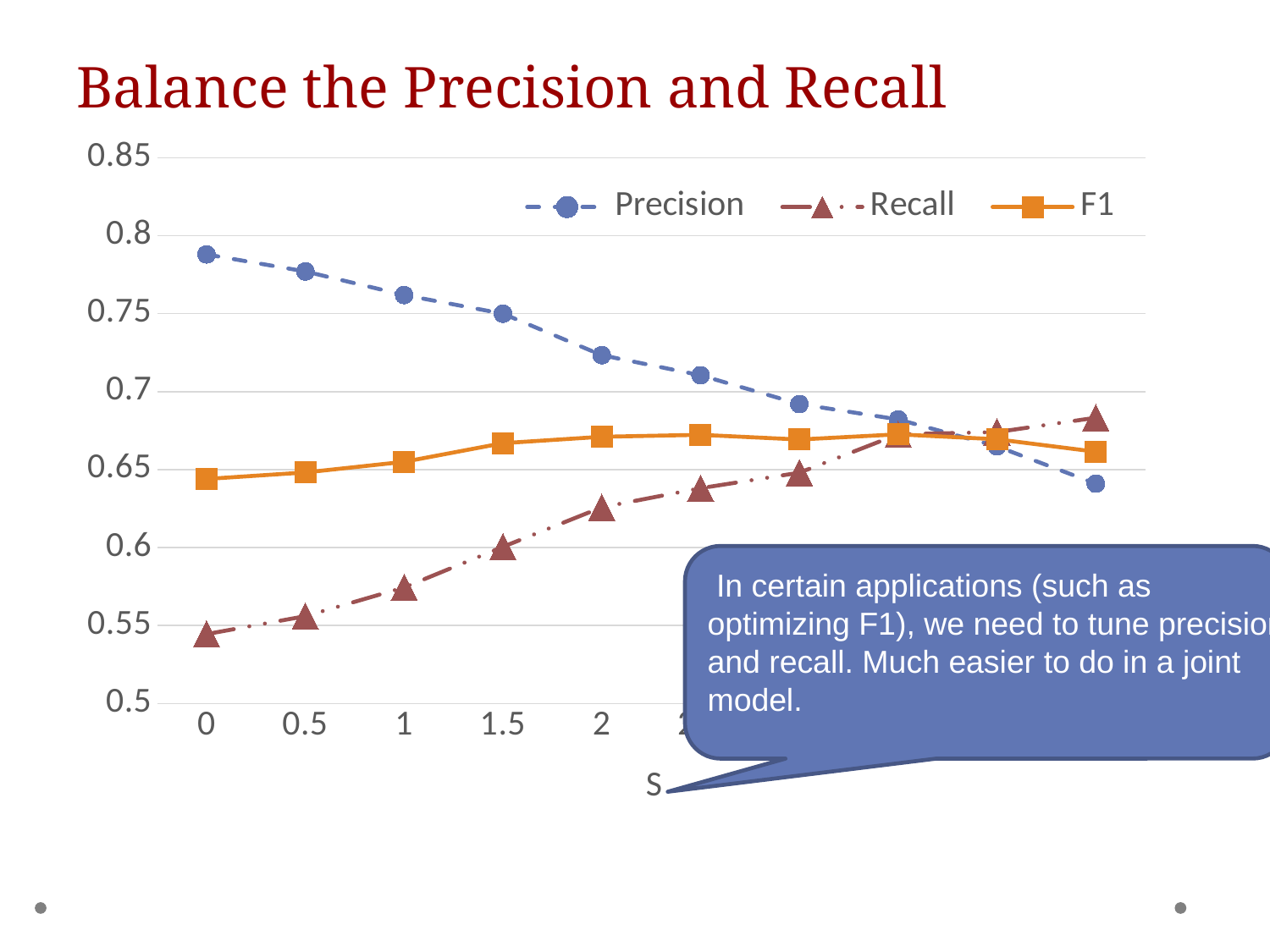
Is the Recall value at S = 0 greater or less than 0.6? less Does the Recall series rise or fall as S increases along the x axis? rise Is the Recall value at S = 2 greater or less than 0.6? greater What kind of chart is shown on the slide? line chart Does the Precision series rise or fall as S increases along the x axis? fall Is the Precision value at S = 0 greater or less than 0.75? greater At S = 0, which series has the higher value, Precision or Recall? Precision Which series are listed in the legend? Precision, Recall, F1 What is the title of the chart on the slide? Balance the Precision and Recall How many series does the legend list? 3 At S = 1, which series has the higher value, F1 or Recall? F1